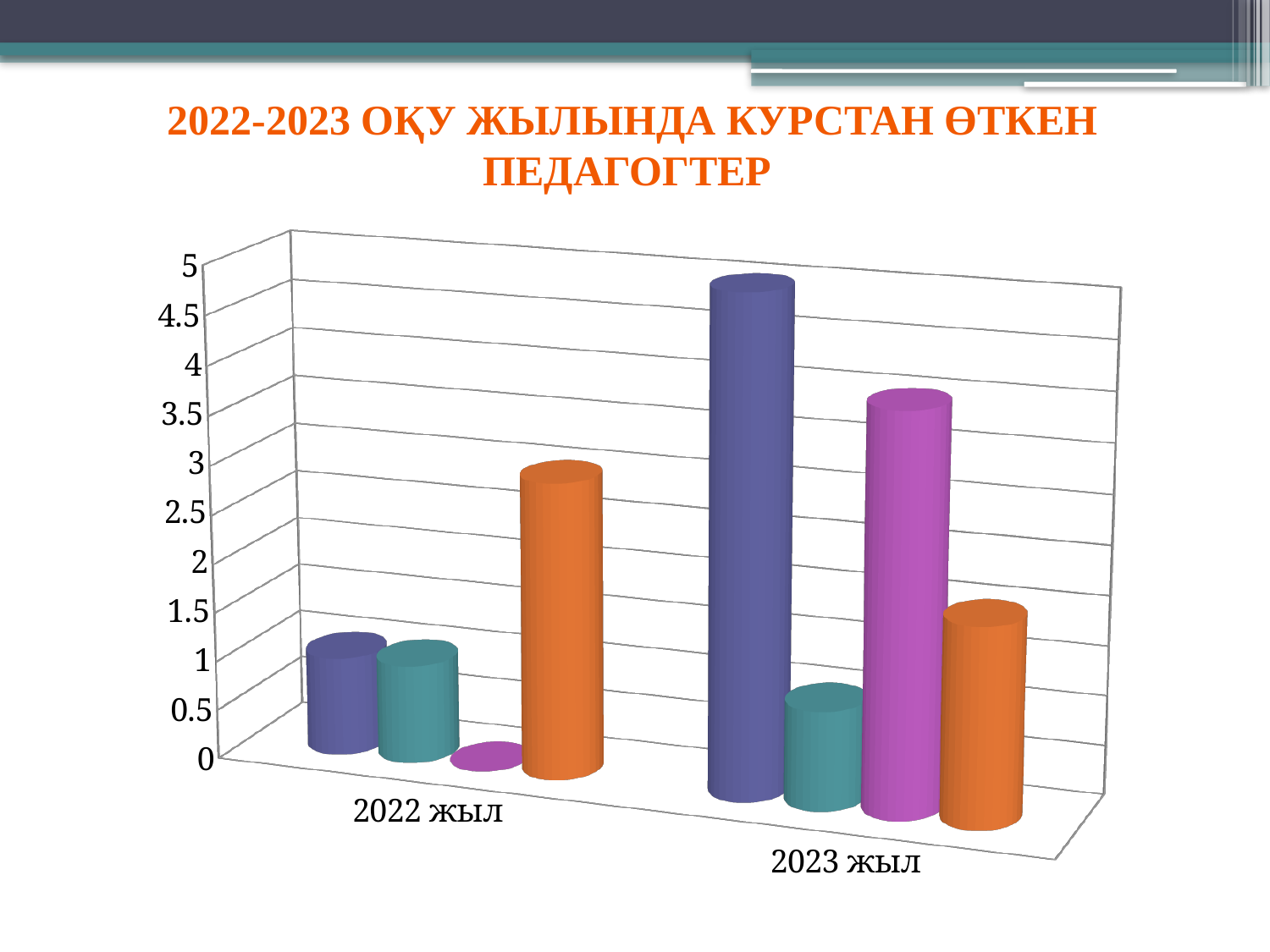
What is the title of the slide containing the chart? 2022-2023 ОҚУ ЖЫЛЫНДА КУРСТАН ӨТКЕН ПЕДАГОГТЕР How many categories are shown on the x axis of the chart? 2 Is the value of the blue bar for 2023 жыл greater or less than 4? greater Is the value of the orange bar for 2022 жыл greater or less than 2? greater Which bar is the tallest in the whole chart? the blue bar for 2023 жыл Which bar is the lowest in the whole chart? the magenta bar for 2022 жыл Which is larger, the blue bar for 2022 жыл or the blue bar for 2023 жыл? 2023 жыл Is the value of the orange bar for 2023 жыл greater or less than 3? less Which is larger, the orange bar for 2022 жыл or the orange bar for 2023 жыл? 2022 жыл What kind of chart is shown on the slide? bar chart